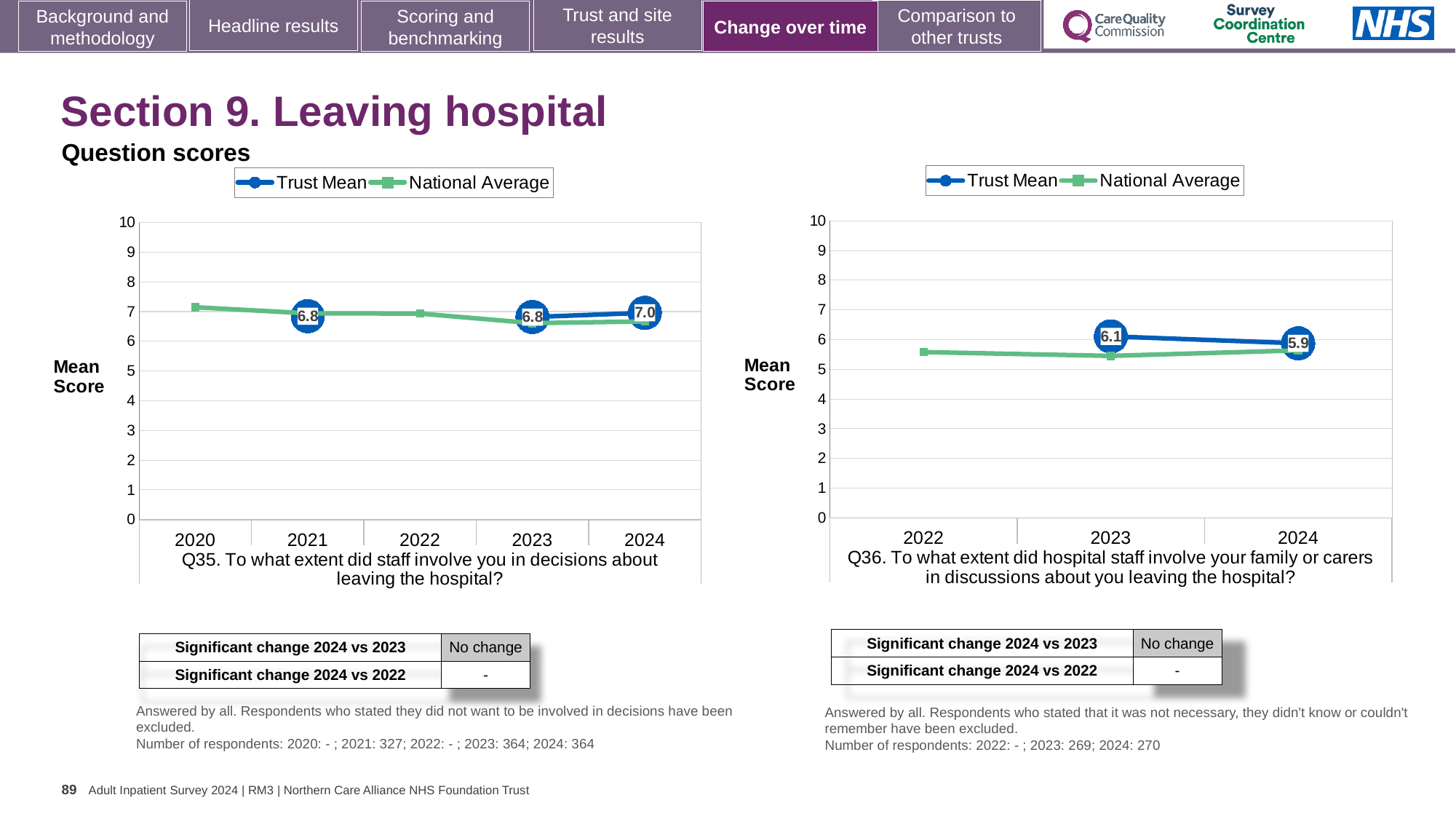
In the Q35 chart on the left, what is the Trust Mean score for 2021? 6.8 In the Q36 chart on the right, what is the difference between the Trust Mean scores for 2023 and 2024? 0.2 In the Q36 chart on the right, does the Trust Mean rise or fall from 2023 to 2024? fall In the Q35 chart on the left, what is the Trust Mean score for 2024? 7.0 How many years are shown on the x axis of the Q35 chart on the left? 5 In the Q36 chart on the right, is the National Average for 2023 greater or less than 6? less In the Q36 chart on the right, what is the Trust Mean score for 2024? 5.9 How many series does the legend of the Q36 chart on the right list? 2 In the Q35 chart on the left, what is the difference between the Trust Mean scores for 2024 and 2023? 0.2 In the Q35 chart on the left, which year has the highest labelled Trust Mean score? 2024 In the Q36 chart on the right, what is the Trust Mean score for 2023? 6.1 What kind of chart is the Q35 chart on the left? line chart